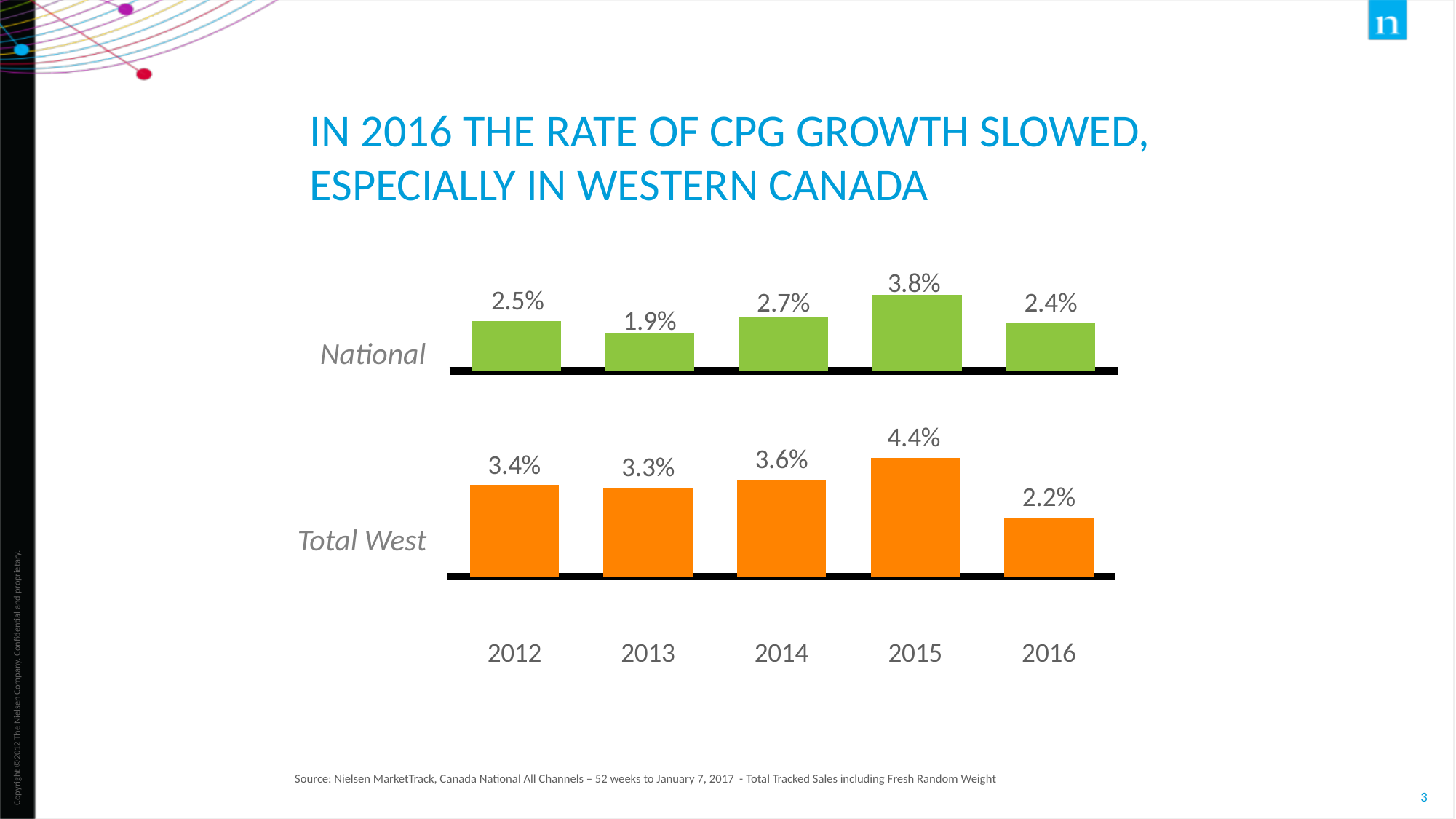
In the Total West chart, what is the value for 2016? 2.2% In the National chart, what is the difference between the 2015 and 2016 values? 1.4% In the National chart, which year has the lowest value? 2013 In the Total West chart, what is the difference between the 2015 and 2016 values? 2.2% In the Total West chart, which year has the lowest value? 2016 How many years are shown on the x axis of the charts? 5 What kind of chart is used to show the National and Total West growth rates? Bar chart In the National chart, what is the value for 2013? 1.9% In the Total West chart, does the value rise or fall from 2015 to 2016? Fall In the Total West chart, which year has the highest value? 2015 For 2014, which is larger: the National value or the Total West value? Total West In the National chart, what is the value for 2015? 3.8%